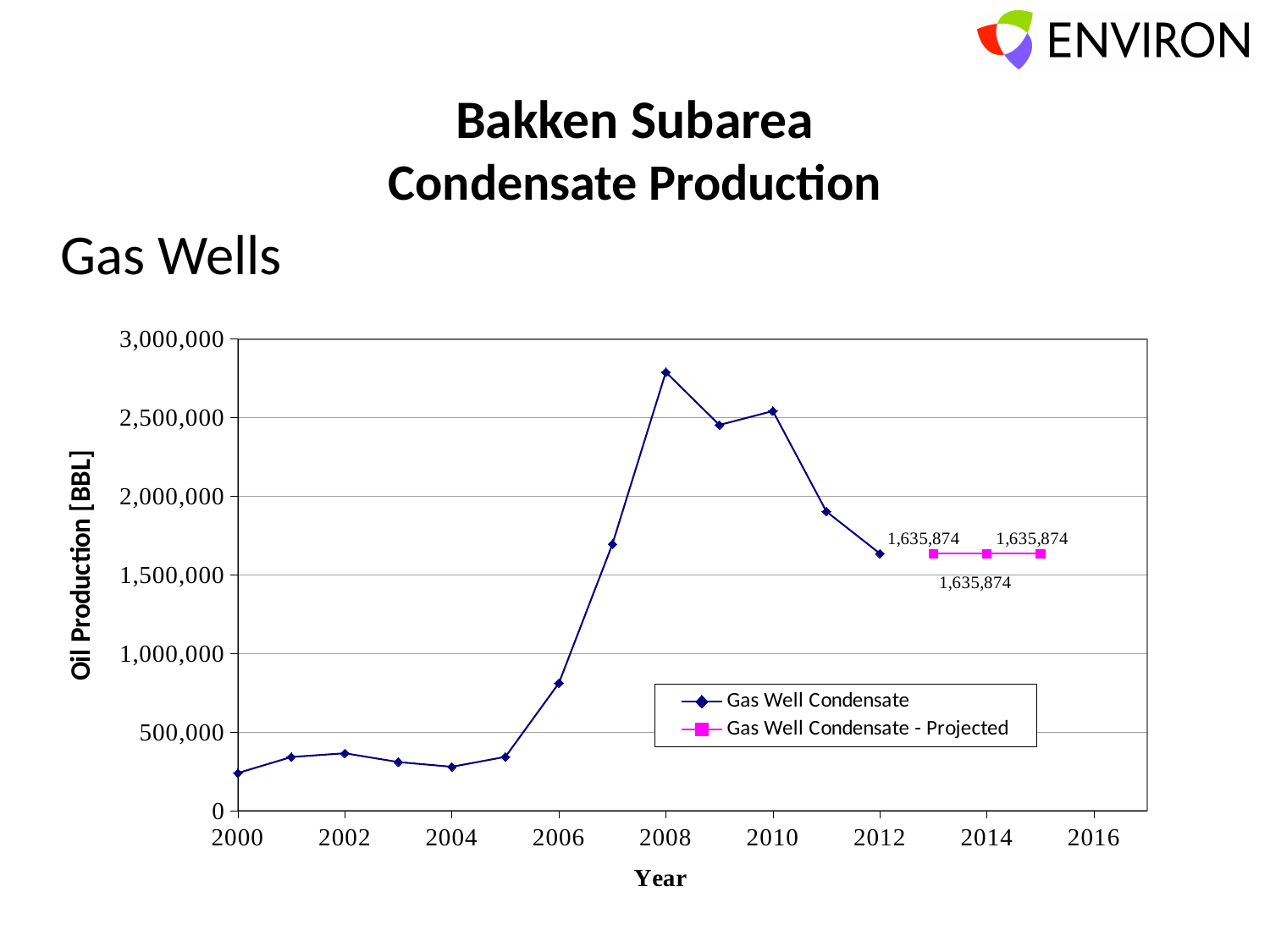
What is the projected Gas Well Condensate value for 2014? 1,635,874 Is the Gas Well Condensate value for 2006 greater or less than 1,000,000? less Which year has the larger Gas Well Condensate value, 2009 or 2010? 2010 Is the Gas Well Condensate value for 2011 greater or less than 1,500,000? greater What is the projected Gas Well Condensate value for 2015? 1,635,874 What kind of chart is shown on the slide? line chart Does Gas Well Condensate production rise or fall from 2005 to 2008? rise In which year is Gas Well Condensate production highest? 2008 What is the label on the y axis? Oil Production [BBL] Is the Gas Well Condensate value for 2008 greater or less than 2,500,000? greater How many data points does the Gas Well Condensate - Projected series have? 3 How many series does the legend list? 2